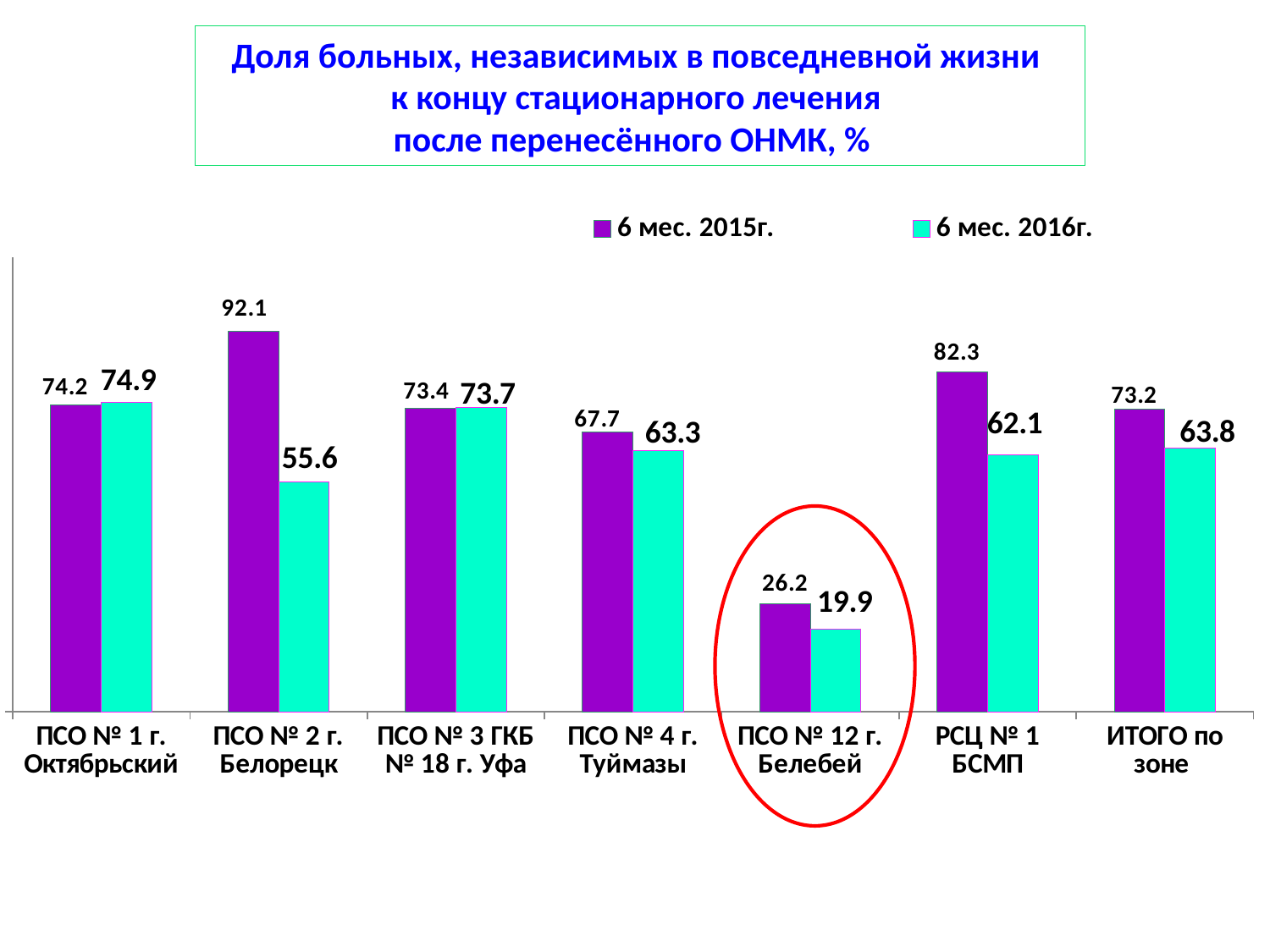
How many series does the legend list? 2 Which is larger for ПСО № 4 г. Туймазы: the 6 мес. 2015г. value or the 6 мес. 2016г. value? 6 мес. 2015г. Which category has the highest value in the 6 мес. 2015г. series? ПСО № 2 г. Белорецк What kind of chart is shown on the slide? Bar chart What is the value for ИТОГО по зоне in the 6 мес. 2015г. series? 73.2 What is the value for ПСО № 12 г. Белебей in the 6 мес. 2016г. series? 19.9 What is the difference between the 6 мес. 2015г. and 6 мес. 2016г. values for ПСО № 2 г. Белорецк? 36.5 Which category is circled in red on the chart? ПСО № 12 г. Белебей What is the value for ПСО № 2 г. Белорецк in the 6 мес. 2015г. series? 92.1 How many categories are shown on the x axis? 7 Which category has the lowest value in the 6 мес. 2016г. series? ПСО № 12 г. Белебей What is the value for РСЦ № 1 БСМП in the 6 мес. 2016г. series? 62.1